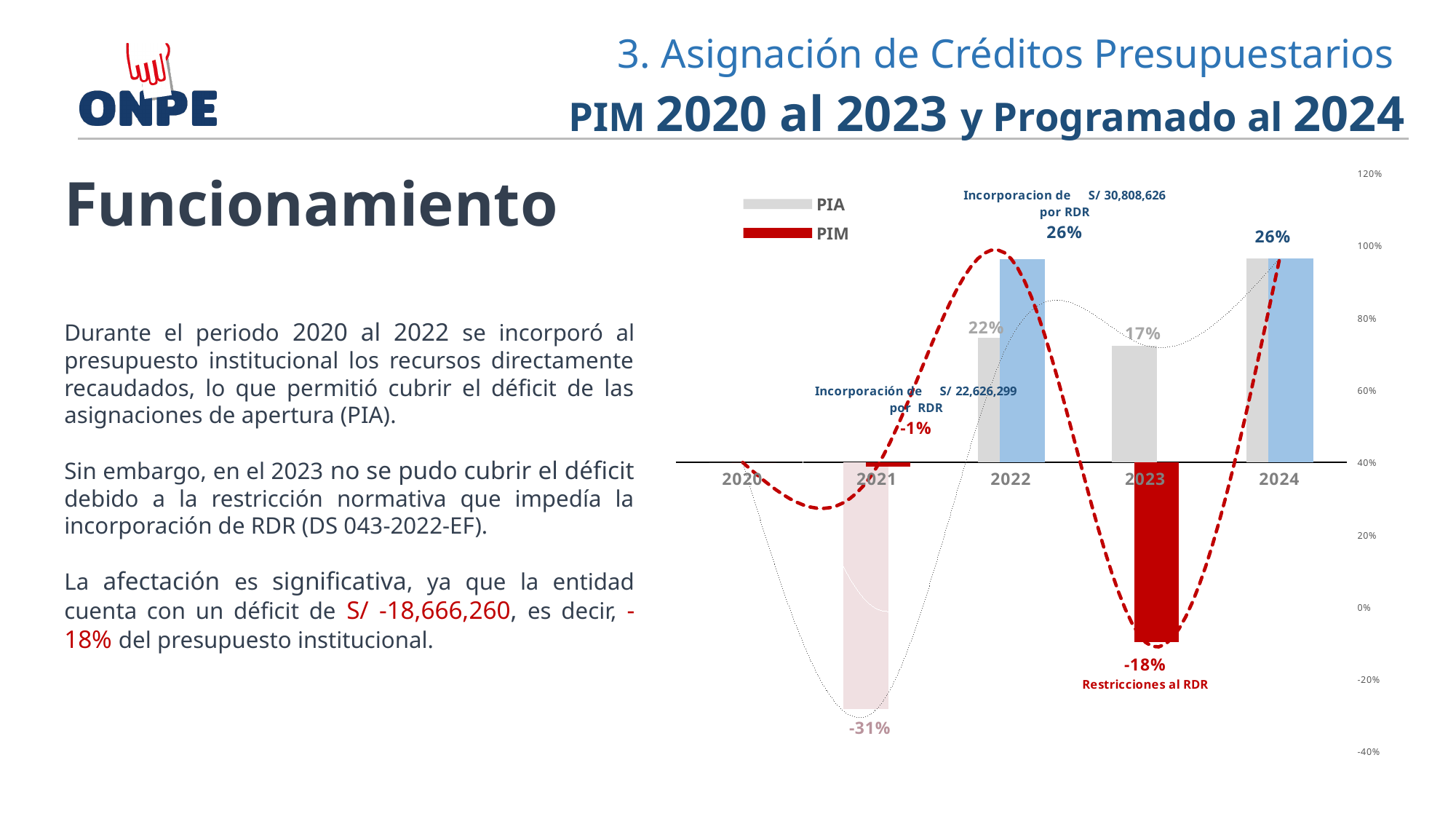
What is the PIM value for 2023? -18% What is the PIA value for 2022? 22% What amount is annotated as incorporated by RDR for 2022? S/ 30,808,626 In 2023, which is larger, the PIA value or the PIM value? PIA What is the PIM value for 2022? 26% In 2022, how much higher is the PIM value than the PIA value? 4 percentage points How many series does the legend list? 2 What is the PIM value for 2021? -1% Which year has the lowest PIM value? 2023 Which year has the lowest PIA value? 2021 What is the PIA value for 2021? -31% What is the PIA value for 2023? 17%